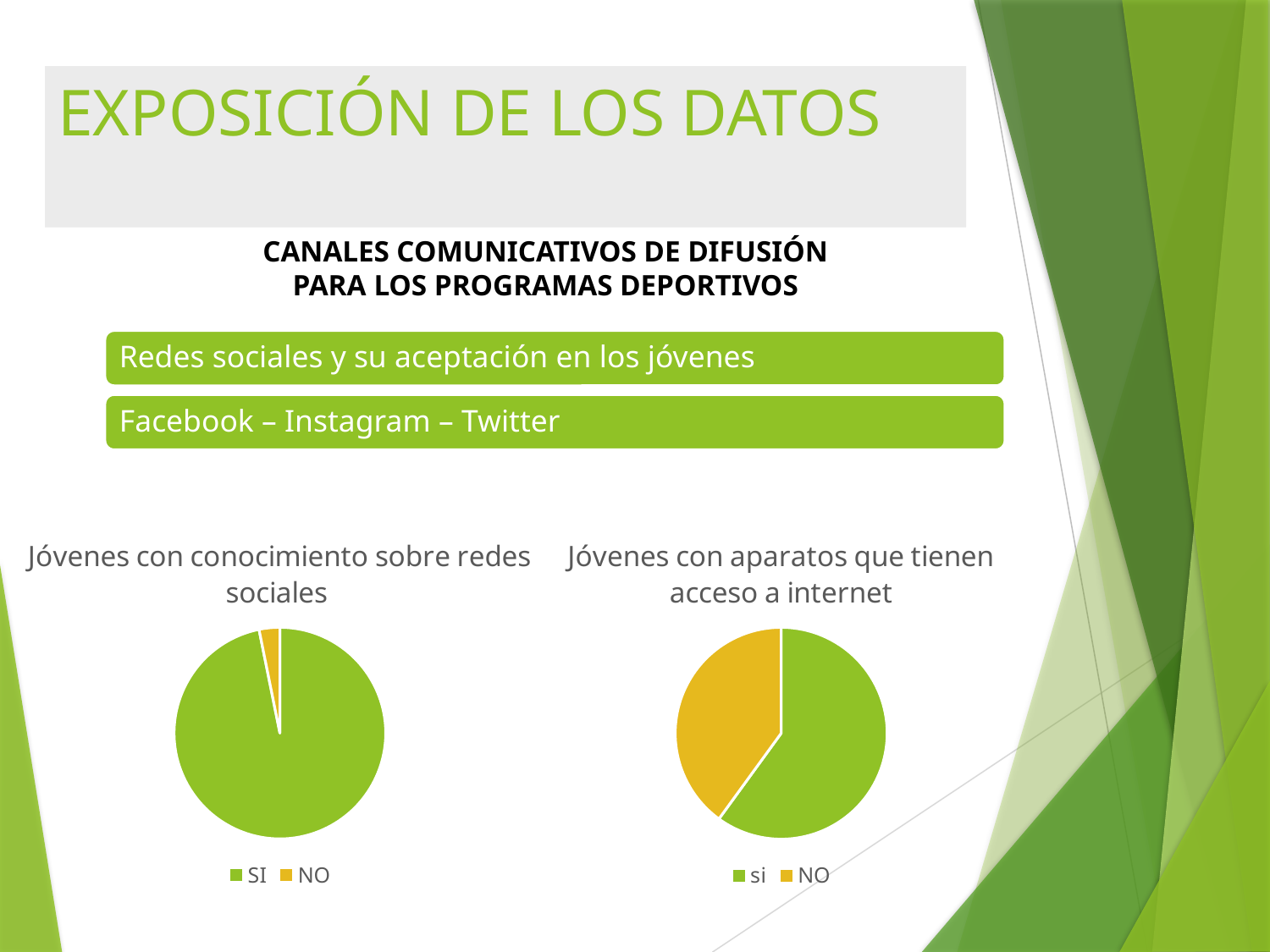
What kind of chart is "Jóvenes con aparatos que tienen acceso a internet"? pie chart What is the title of the pie chart on the left of the slide? Jóvenes con conocimiento sobre redes sociales How many entries does the legend of the chart "Jóvenes con aparatos que tienen acceso a internet" list? 2 What kind of chart is "Jóvenes con conocimiento sobre redes sociales"? pie chart In the chart "Jóvenes con aparatos que tienen acceso a internet", which category has the smallest slice? NO In the chart "Jóvenes con aparatos que tienen acceso a internet", which category has the largest slice? si In the chart "Jóvenes con conocimiento sobre redes sociales", which category has the smallest slice? NO In the chart "Jóvenes con conocimiento sobre redes sociales", which category has the largest slice? SI In the chart "Jóvenes con aparatos que tienen acceso a internet", what colour is the NO slice? yellow How many slices does the pie chart "Jóvenes con conocimiento sobre redes sociales" have? 2 In the chart "Jóvenes con aparatos que tienen acceso a internet", which slice is larger, si or NO? si In the chart "Jóvenes con conocimiento sobre redes sociales", which slice is larger, SI or NO? SI